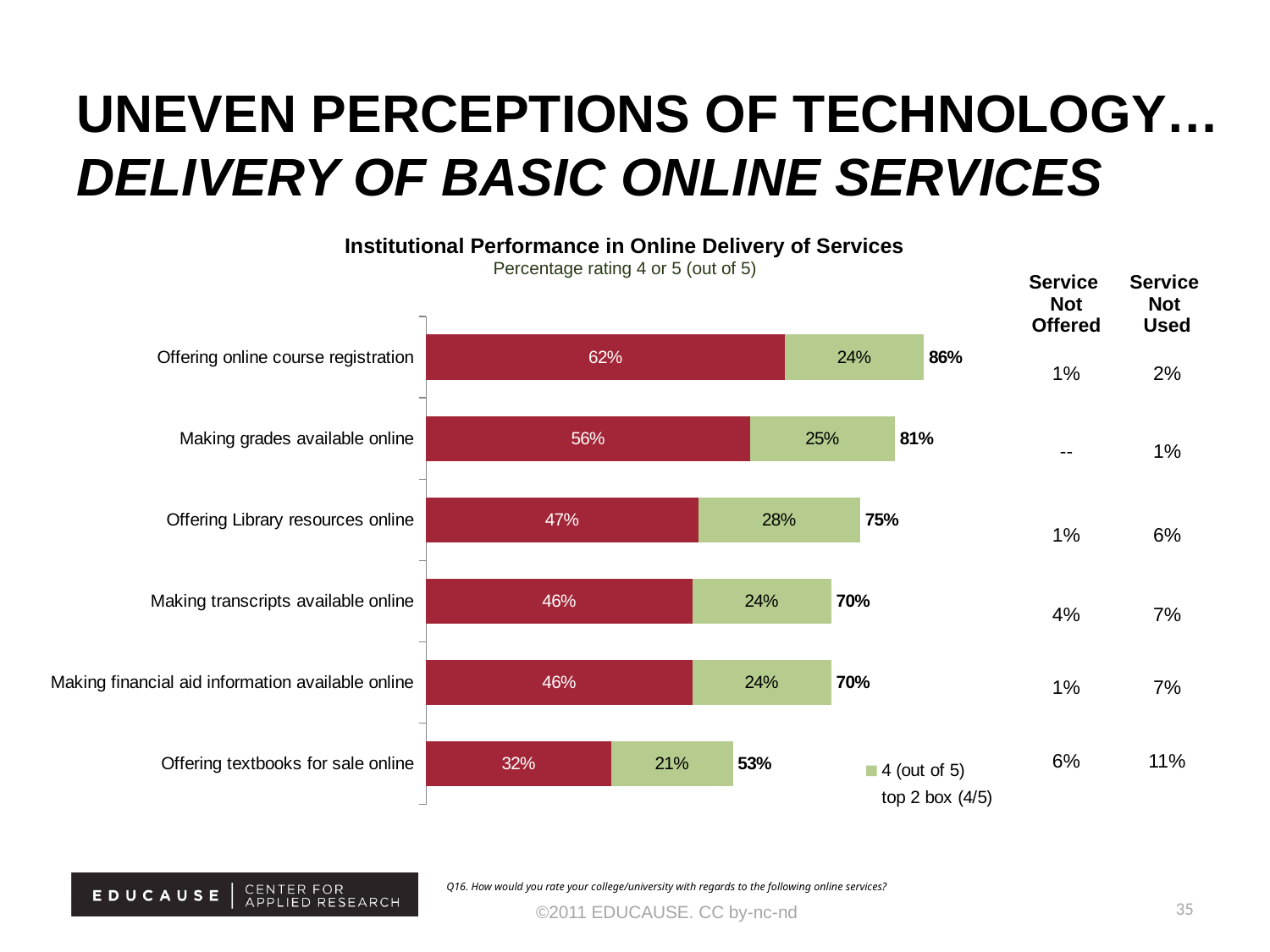
What is the total (top 2 box) percentage for Making transcripts available online? 70% Which service has the highest total (top 2 box) percentage? Offering online course registration What is the total (top 2 box) percentage for Offering online course registration? 86% Which has a larger green '4 (out of 5)' segment: Making grades available online or Offering textbooks for sale online? Making grades available online What is the 'Service Not Used' percentage shown for Offering textbooks for sale online? 11% What type of chart is shown on the slide? Stacked bar chart What is the value of the red segment for Making grades available online? 56% What is the value of the green '4 (out of 5)' segment for Offering Library resources online? 28% Which service has the lowest total (top 2 box) percentage? Offering textbooks for sale online What is the chart title? Institutional Performance in Online Delivery of Services How many service categories are plotted in the chart? 6 What is the difference between the total percentages for Offering online course registration and Offering textbooks for sale online? 33%